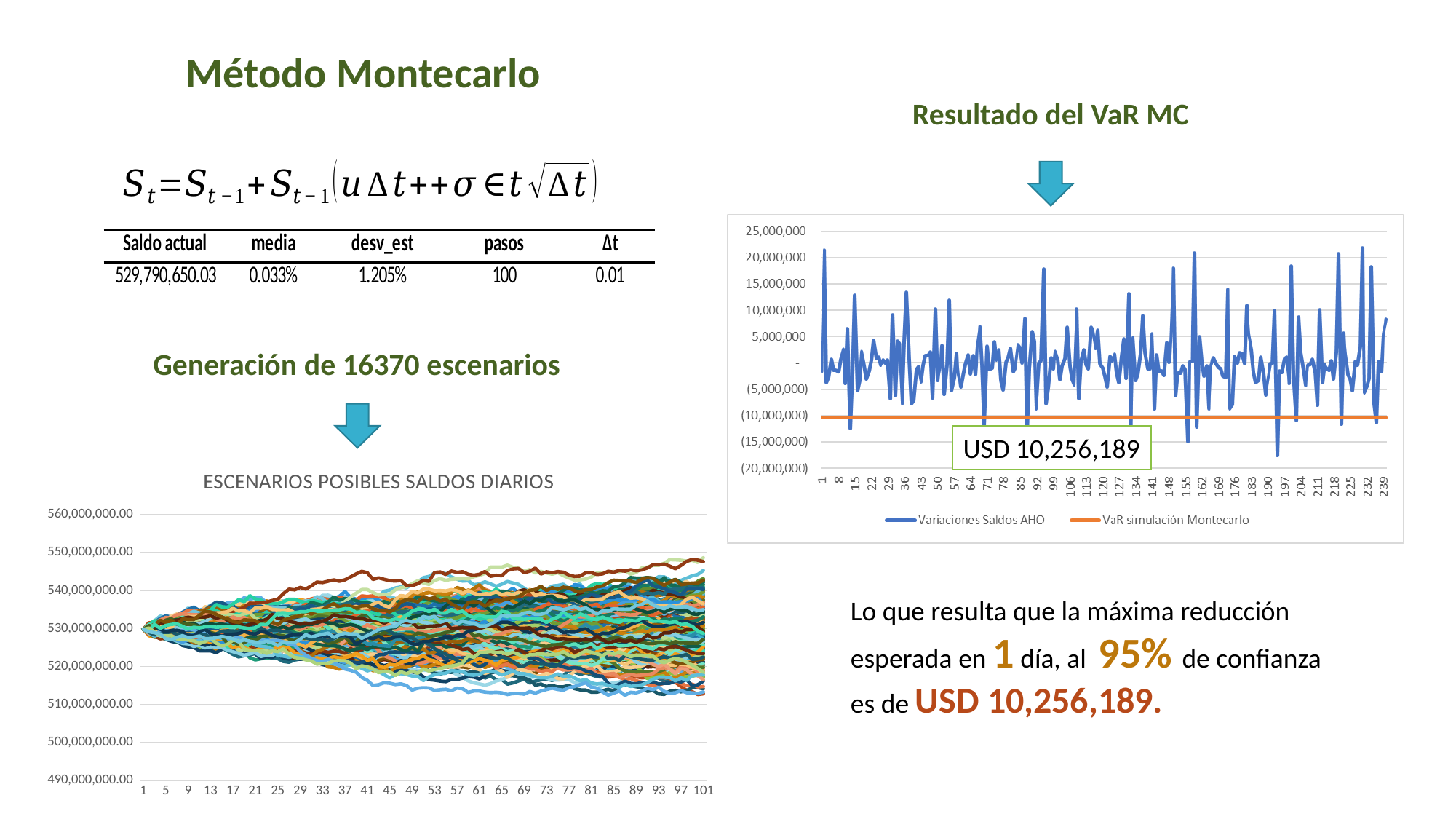
In the chart titled 'ESCENARIOS POSIBLES SALDOS DIARIOS', is the highest line at point 101 greater or less than 540,000,000.00? greater In the chart under 'Resultado del VaR MC', how many series does the legend list? 2 In the chart under 'Resultado del VaR MC', what is the last label on the horizontal axis? 239 In the chart under 'Resultado del VaR MC', is the lowest point of Variaciones Saldos AHO greater or less than (15,000,000)? less In the chart under 'Resultado del VaR MC', what is the highest value shown on the vertical axis? 25,000,000 In the chart titled 'ESCENARIOS POSIBLES SALDOS DIARIOS', what is the last label on the horizontal axis? 101 In the chart under 'Resultado del VaR MC', what value is printed in the box next to the VaR simulación Montecarlo line? USD 10,256,189 What kind of chart is the chart titled 'ESCENARIOS POSIBLES SALDOS DIARIOS'? line chart In the chart under 'Resultado del VaR MC', is the highest peak of Variaciones Saldos AHO greater or less than 20,000,000? greater What kind of chart is the chart under 'Resultado del VaR MC' on the right? line chart In the chart under 'Resultado del VaR MC', what are the two legend entries? Variaciones Saldos AHO; VaR simulación Montecarlo